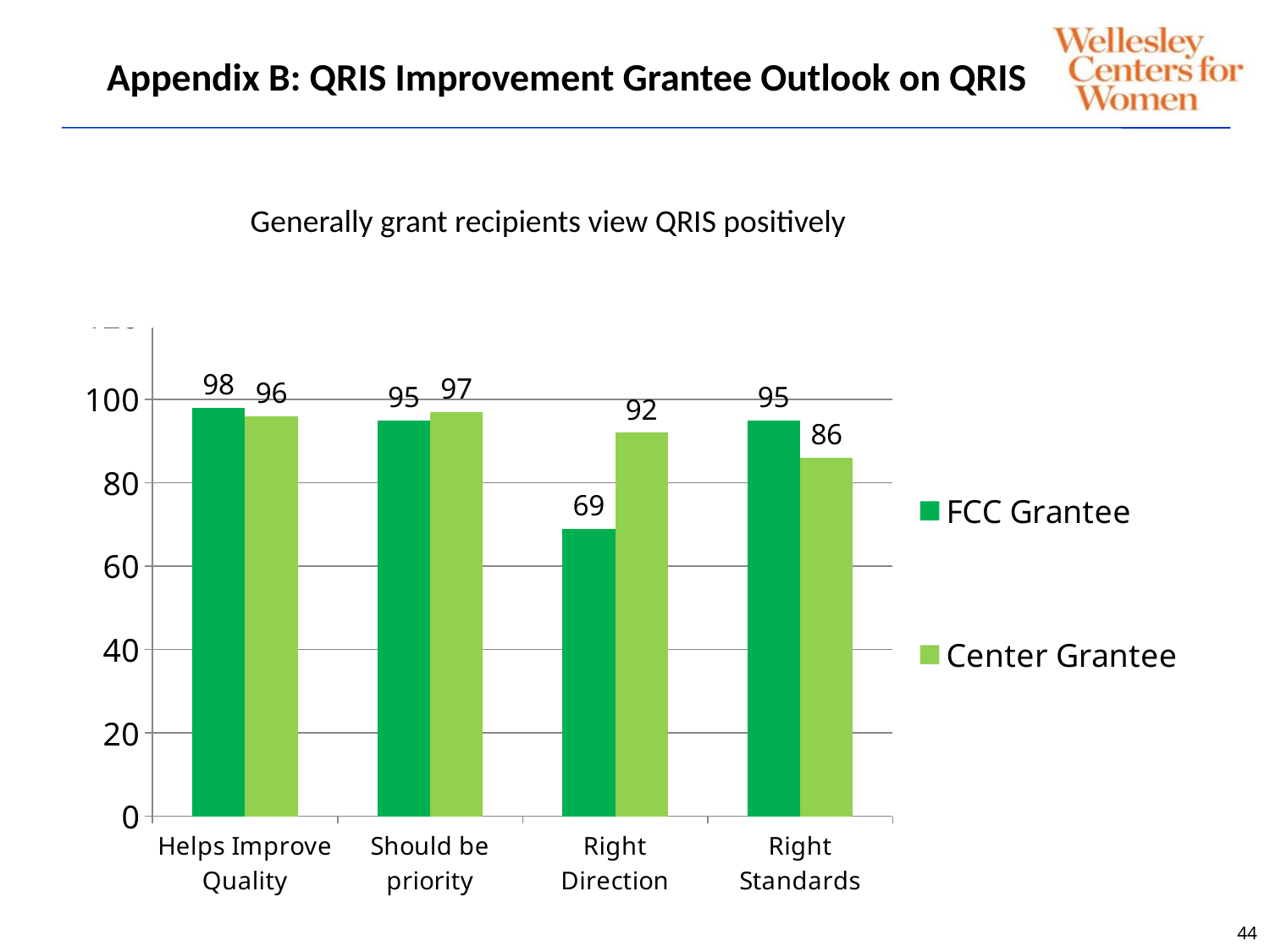
What is the value for Center Grantee in the Right Direction category? 92 Which category has the lowest value for FCC Grantee? Right Direction What is the value for Center Grantee in the Right Standards category? 86 What is the difference between the Center Grantee and FCC Grantee values in the Right Direction category? 23 In the Right Standards category, which is larger: FCC Grantee or Center Grantee? FCC Grantee Is the value for FCC Grantee in the Right Direction category greater or less than 80? less What is the value for FCC Grantee in the Helps Improve Quality category? 98 What kind of chart is shown on the slide? bar chart How many series does the legend list? 2 How many categories are shown on the x axis? 4 Which category has the highest value for Center Grantee? Should be priority What are the two series named in the legend? FCC Grantee and Center Grantee